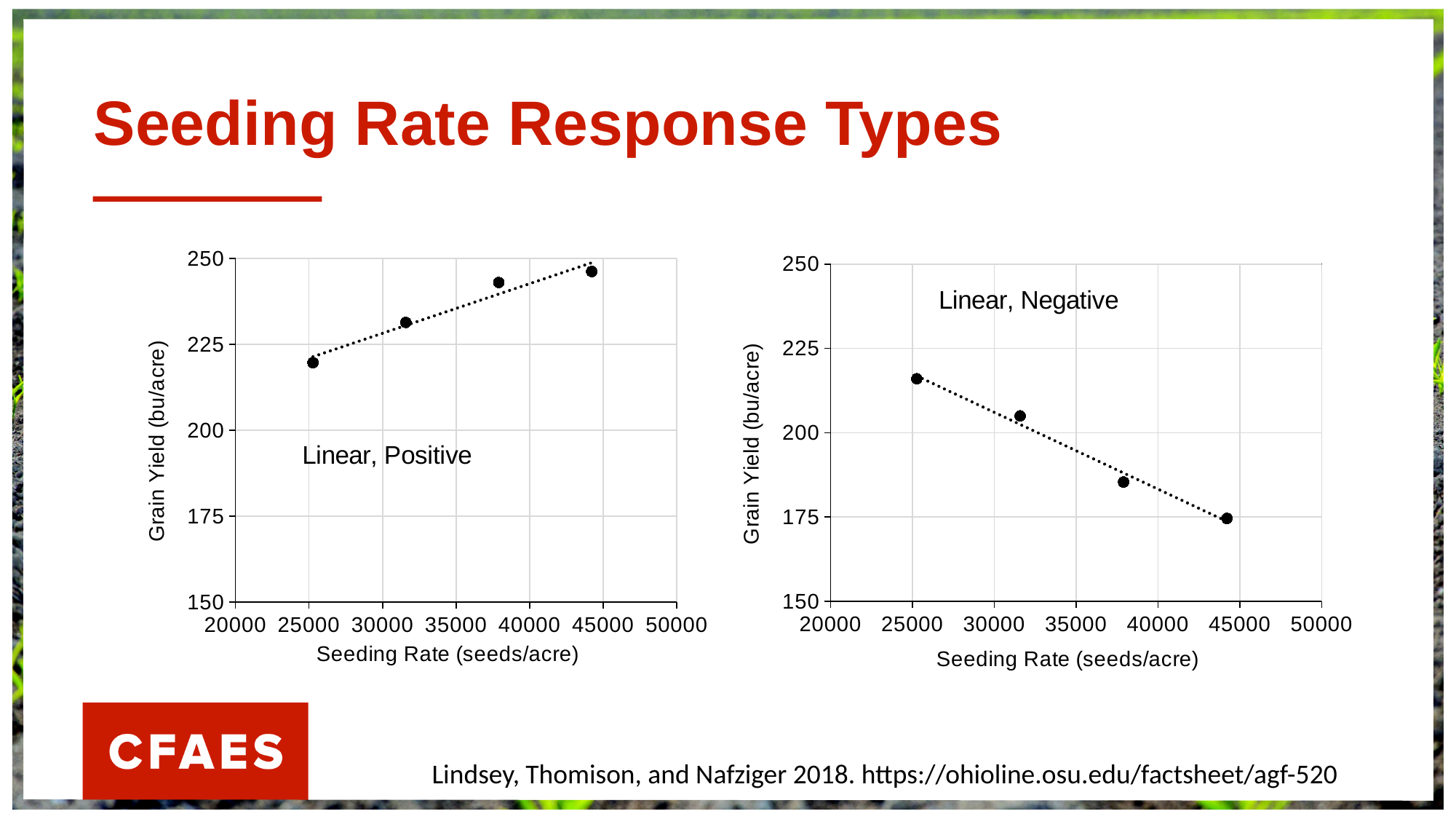
On the right chart ("Linear, Negative"), is the grain yield at the lowest seeding rate greater or less than 225 bu/acre? less On the right chart ("Linear, Negative"), which point has the highest grain yield? The point at the lowest seeding rate How many data points are plotted on the left chart ("Linear, Positive")? 4 On the left chart ("Linear, Positive"), is the grain yield at the lowest seeding rate greater or less than 200 bu/acre? greater What is the x-axis title on both charts? Seeding Rate (seeds/acre) On the left chart ("Linear, Positive"), does grain yield rise or fall as seeding rate increases? Rises On the right chart ("Linear, Negative"), does grain yield rise or fall as seeding rate increases? Falls On the right chart ("Linear, Negative"), is the grain yield at the highest seeding rate greater or less than 200 bu/acre? less On the left chart ("Linear, Positive"), which has the higher grain yield: the point at the lowest seeding rate or the point at the highest seeding rate? The point at the highest seeding rate What kind of chart is the left chart, labelled "Linear, Positive"? Scatter chart What is the y-axis title on both charts? Grain Yield (bu/acre) How many data points are plotted on the right chart ("Linear, Negative")? 4